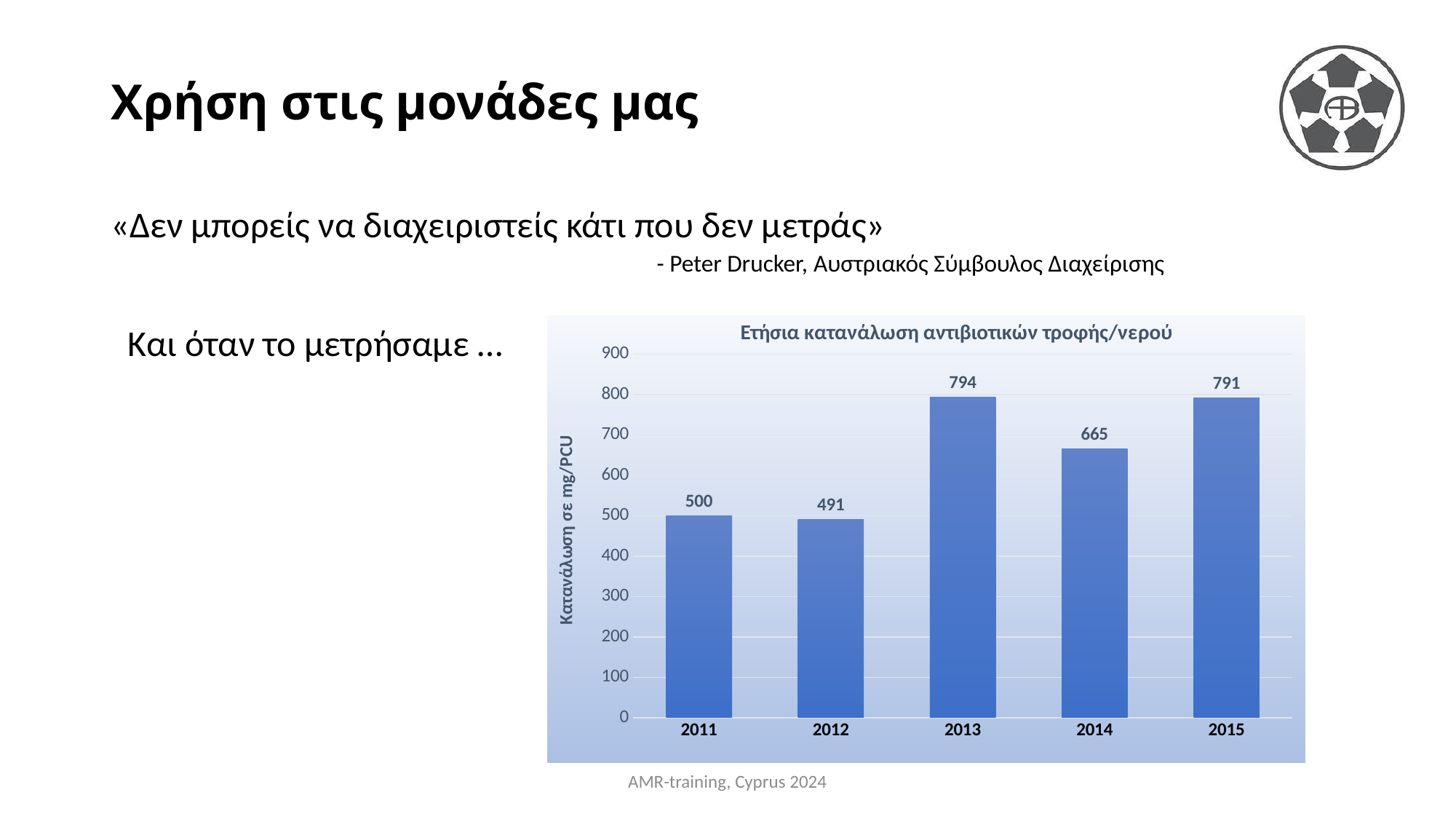
What is the value for 2011? 500 Which is larger, the value for 2014 or the value for 2011? 2014 Which year has the lowest value? 2012 What kind of chart is shown on the slide? bar chart How many years are shown on the x axis? 5 Is the value for 2013 greater or less than 700? greater What is the value for 2014? 665 What is the difference between the values for 2015 and 2014? 126 What is the difference between the values for 2013 and 2012? 303 What is the title of the chart? Ετήσια κατανάλωση αντιβιοτικών τροφής/νερού Which year has the highest value? 2013 What is the value for 2015? 791